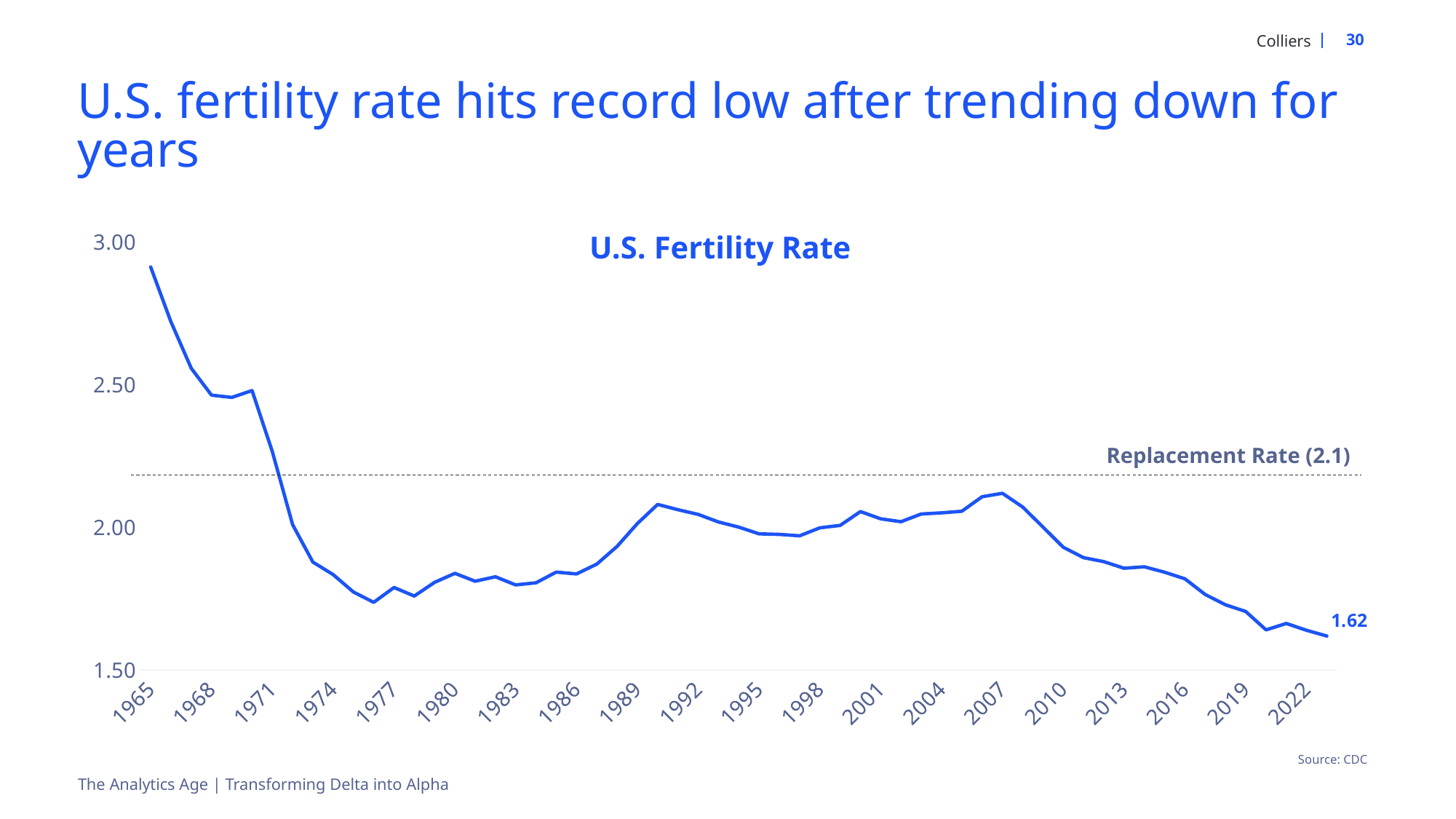
What value is printed as the data label at the end of the line? 1.62 Is the fertility rate for 1977 greater or less than 2.00? less What is the title of the chart? U.S. Fertility Rate Overall, does the fertility rate rise or fall from 1965 to the end of the series? fall Is the fertility rate for 1965 greater or less than 2.50? greater Which year has the higher fertility rate, 1977 or 1989? 1989 Is the fertility rate for 2007 greater or less than 2.00? greater Which year on the x axis has the highest fertility rate? 1965 What replacement rate value is shown on the dashed reference line? 2.1 Which year has the higher fertility rate, 1965 or 2022? 1965 What kind of chart is shown on the slide? line chart